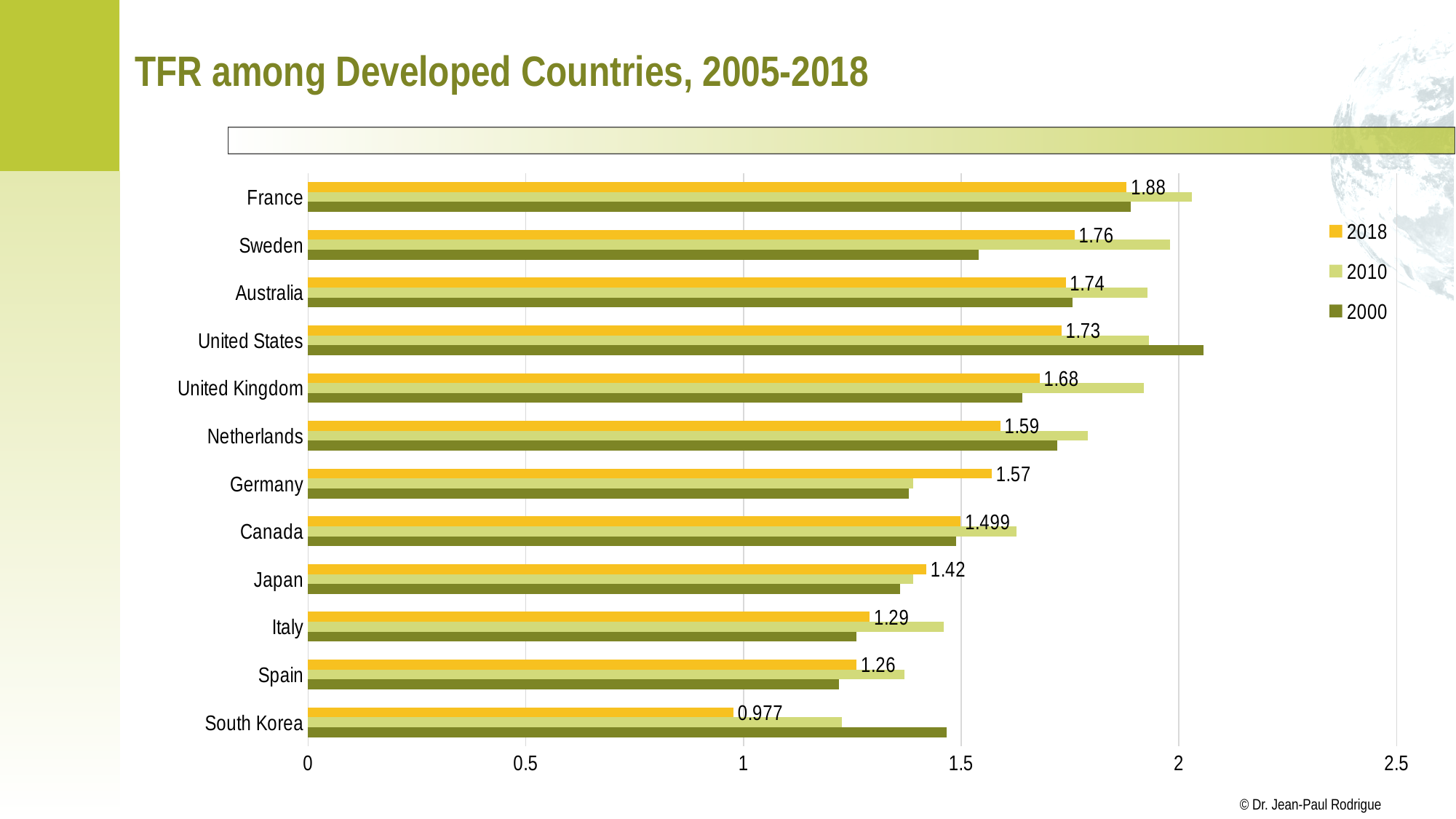
Which has a larger 2018 TFR value, Japan or Italy? Japan Is the 2000 TFR value for the United States greater or less than 2? greater Which country has the lowest 2018 TFR value? South Korea How many series does the legend list? 3 What is the difference between the 2018 TFR values for France and South Korea? 0.903 What is the 2018 TFR value for South Korea? 0.977 Is the 2010 TFR value for Sweden greater or less than 1.5? greater Which country has the highest 2018 TFR value? France What kind of chart is shown on the slide? Bar chart How many countries are shown on the chart? 12 What is the 2018 TFR value for France? 1.88 What is the 2018 TFR value for Canada? 1.499